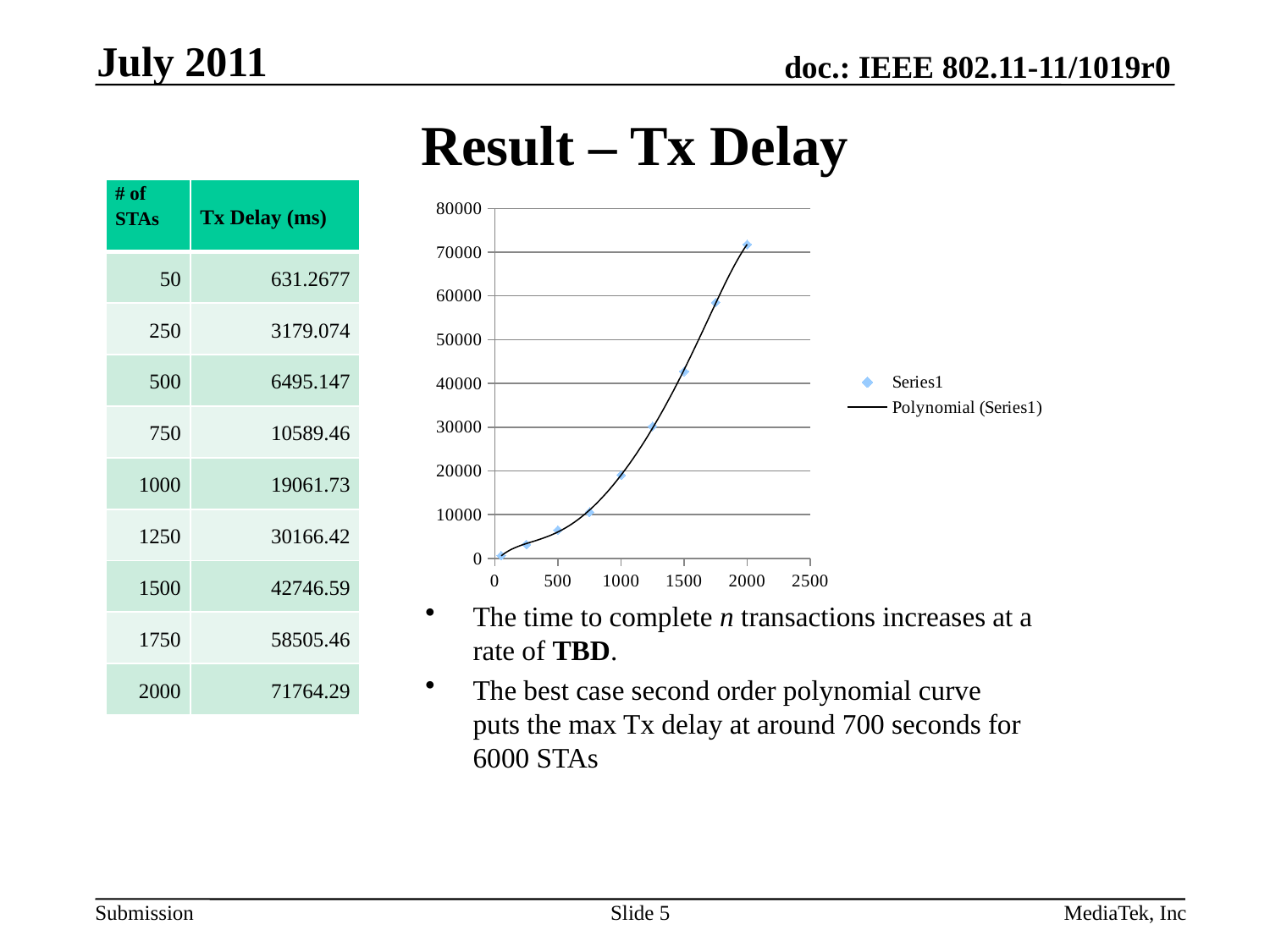
What kind of chart is shown on the slide? scatter chart Is the plotted value at 1500 STAs greater or less than 40000? greater At which number of STAs is the Tx delay lowest? 50 What are the two entries in the chart legend? Series1 and Polynomial (Series1) How many data points are plotted in the chart? 9 How many entries does the chart legend list? 2 Is the plotted value at 1750 STAs greater or less than 50000? greater Is the plotted value at 500 STAs greater or less than 10000? less Which is larger, the Tx delay at 1500 STAs or at 1000 STAs? 1500 STAs According to the table on the slide, what is the Tx delay (ms) for 1000 STAs? 19061.73 Do the plotted values rise or fall as the number of STAs increases along the x axis? rise At which number of STAs is the Tx delay highest? 2000